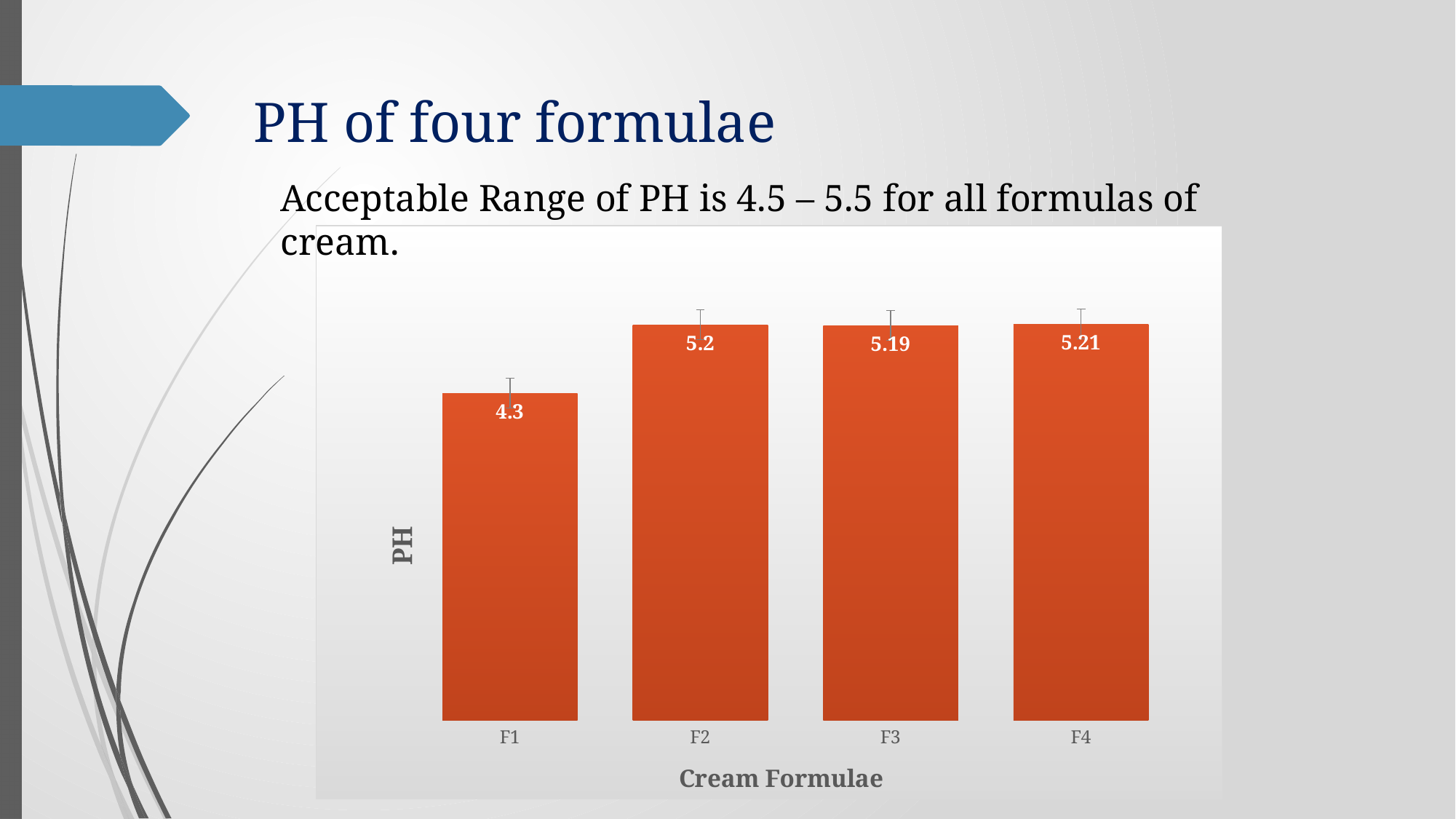
Which has a higher PH, F1 or F4? F4 What is the difference in PH between F2 and F1? 0.9 What is the difference in PH between F4 and F3? 0.02 How many cream formulae are shown in the chart? 4 What is the PH value for F3? 5.19 Which has a higher PH, F1 or F2? F2 What type of chart is used to show the PH of the formulae? Bar chart What is the PH value for F2? 5.2 What is the PH value for F4? 5.21 What is the title of the x axis of the chart? Cream Formulae Which cream formula has the lowest PH? F1 What is the PH value for F1? 4.3